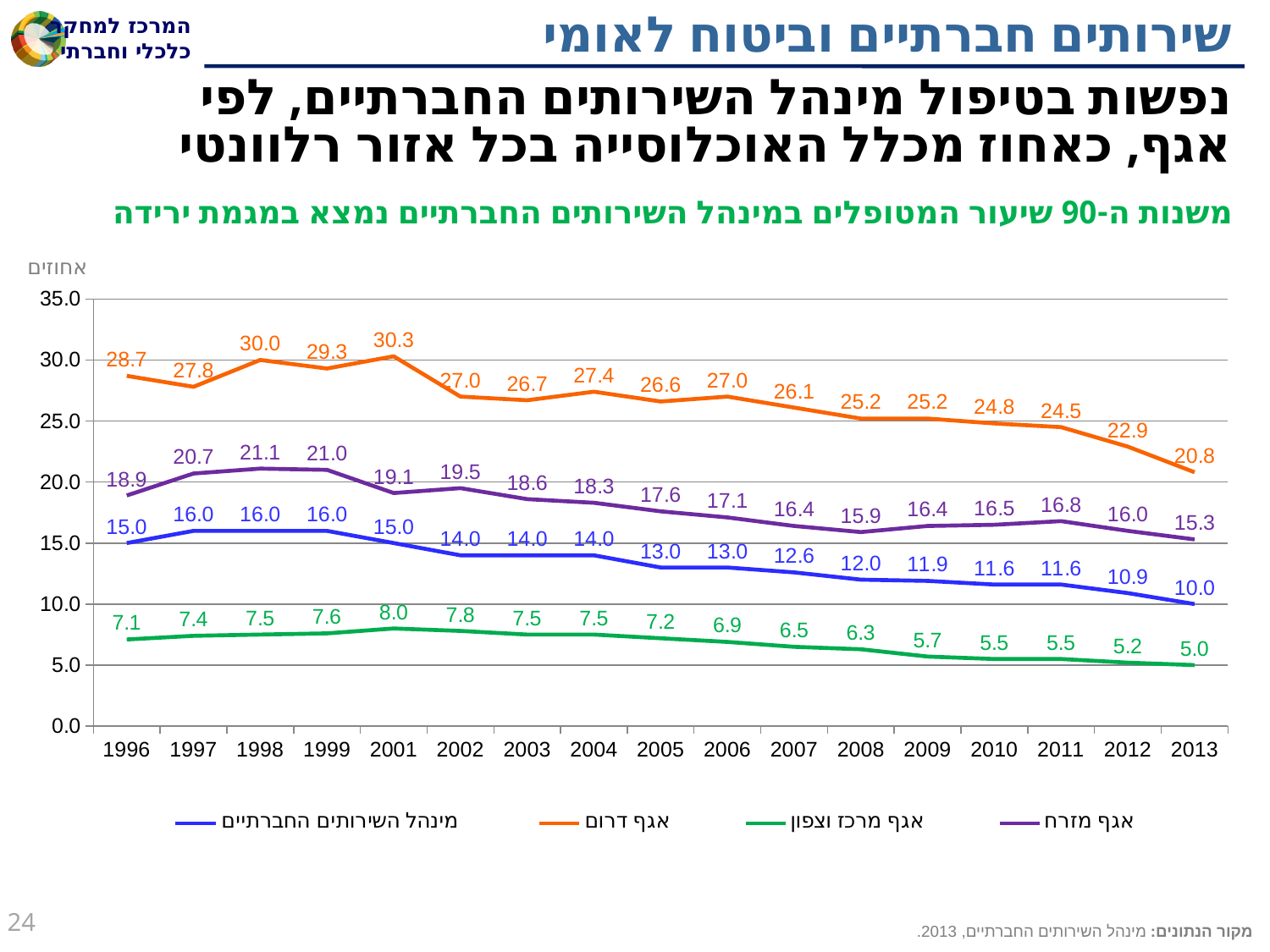
How many series does the legend list? 4 What type of chart is shown on the slide? line chart What is the value for אגף מרכז וצפון in 2013? 5.0 What is the value for אגף מזרח in 1998? 21.1 Which series is drawn in orange? אגף דרום Does the value for אגף מרכז וצפון rise or fall from 2001 to 2013? fall What is the value for אגף דרום in 2001? 30.3 What is the difference between the אגף דרום value in 1996 and in 2013? 7.9 In which year does אגף דרום reach its highest value? 2001 Which series has the higher value in 2005: אגף מזרח or מינהל השירותים החברתיים? אגף מזרח In which year is the value for מינהל השירותים החברתיים lowest? 2013 How many years are plotted along the x axis? 17